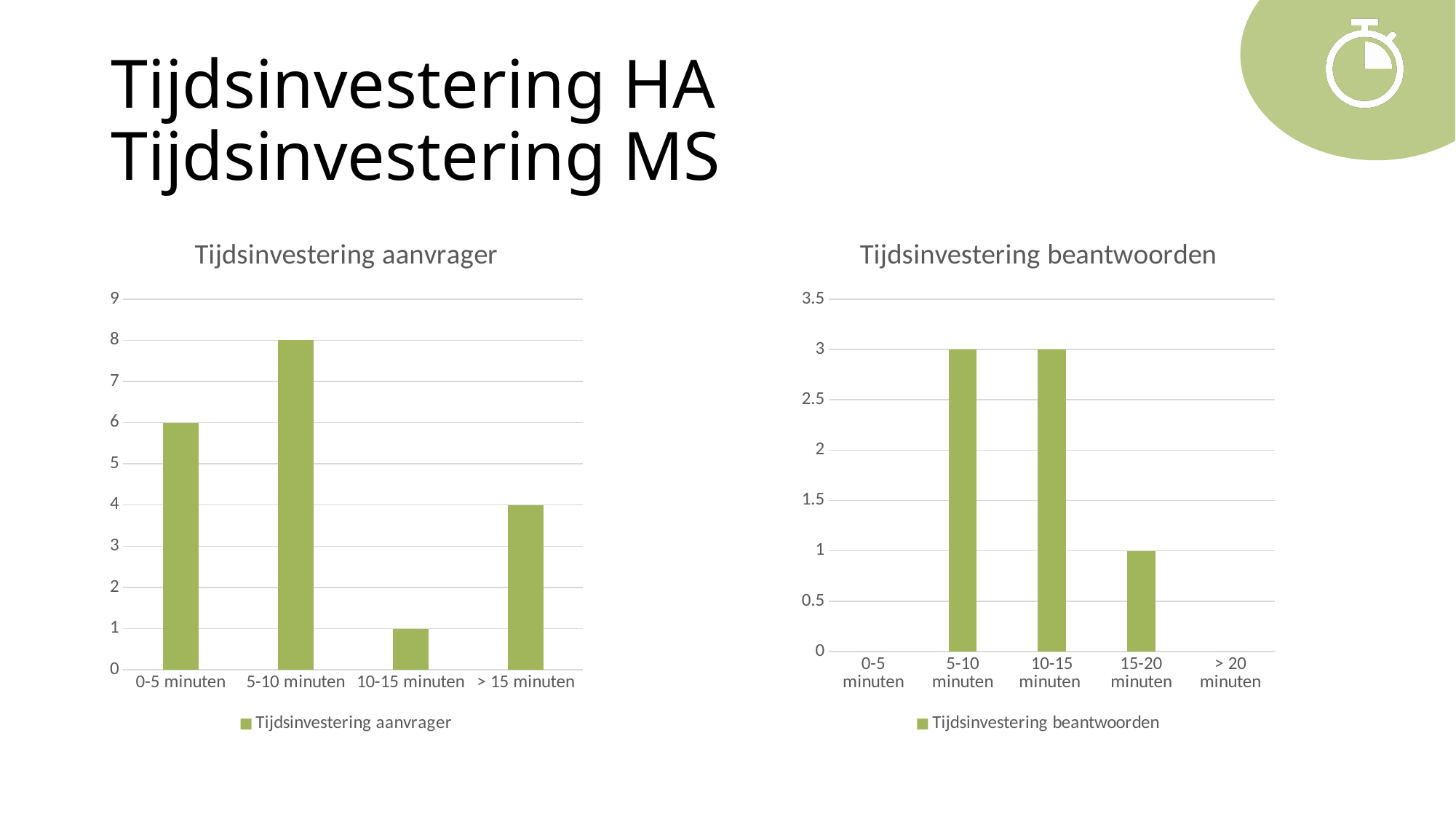
What kind of chart is the 'Tijdsinvestering beantwoorden' chart? Bar chart How many series does the legend of the 'Tijdsinvestering aanvrager' chart list? 1 In the 'Tijdsinvestering beantwoorden' chart, what is the value for 10-15 minuten? 3 In the 'Tijdsinvestering aanvrager' chart, what is the value for 0-5 minuten? 6 In the 'Tijdsinvestering beantwoorden' chart, how many categories are shown on the x axis? 5 In the 'Tijdsinvestering aanvrager' chart, how many categories are shown on the x axis? 4 In the 'Tijdsinvestering aanvrager' chart, which category has the highest value? 5-10 minuten In the 'Tijdsinvestering aanvrager' chart, which category has the lowest value? 10-15 minuten In the 'Tijdsinvestering aanvrager' chart, what is the difference between the values for 5-10 minuten and > 15 minuten? 4 In the 'Tijdsinvestering beantwoorden' chart, which is larger, the value for 5-10 minuten or the value for 15-20 minuten? 5-10 minuten In the 'Tijdsinvestering aanvrager' chart, what is the value for 5-10 minuten? 8 In the 'Tijdsinvestering beantwoorden' chart, what is the value for 15-20 minuten? 1